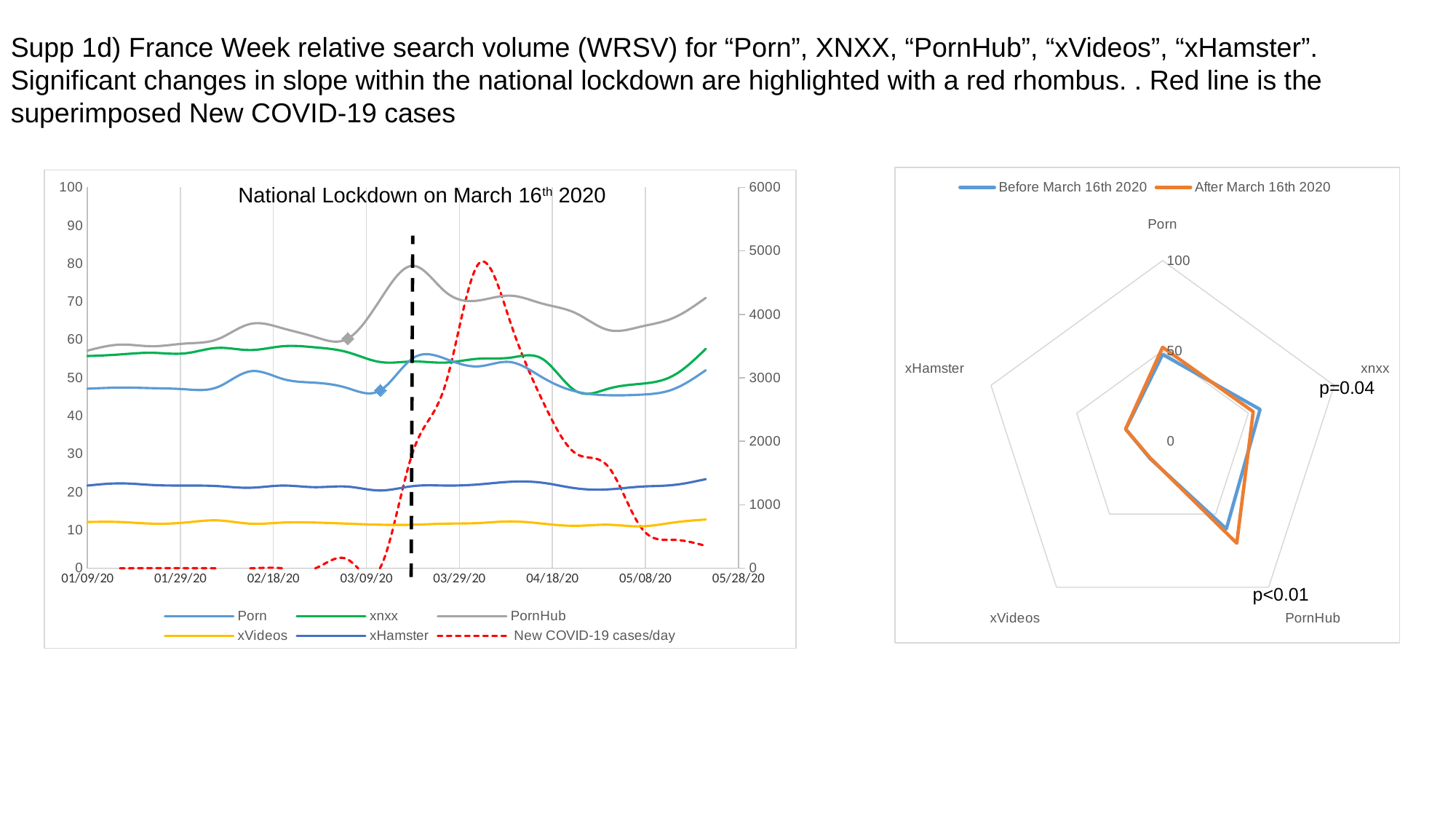
What kind of chart is the left chart? line chart In the right chart, what p-value is annotated next to the PornHub axis? p<0.01 How many series does the legend of the left chart list? 6 What kind of chart is the right chart? radar chart In the left chart, is the PornHub value on 03/09/20 greater or less than 50? greater In the left chart, is the xHamster value on 01/09/20 greater or less than 30? less How many series does the legend of the right chart list? 2 In the left chart, is the peak of New COVID-19 cases/day greater or less than 4000 on the right axis? greater In the left chart, which search term has the lowest WRSV line across the period? xVideos In the left chart, which is larger on 01/09/20, the xnxx value or the Porn value? xnxx How many categories (axes) does the right radar chart have? 5 In the left chart, which search term has the highest WRSV line across the period? PornHub